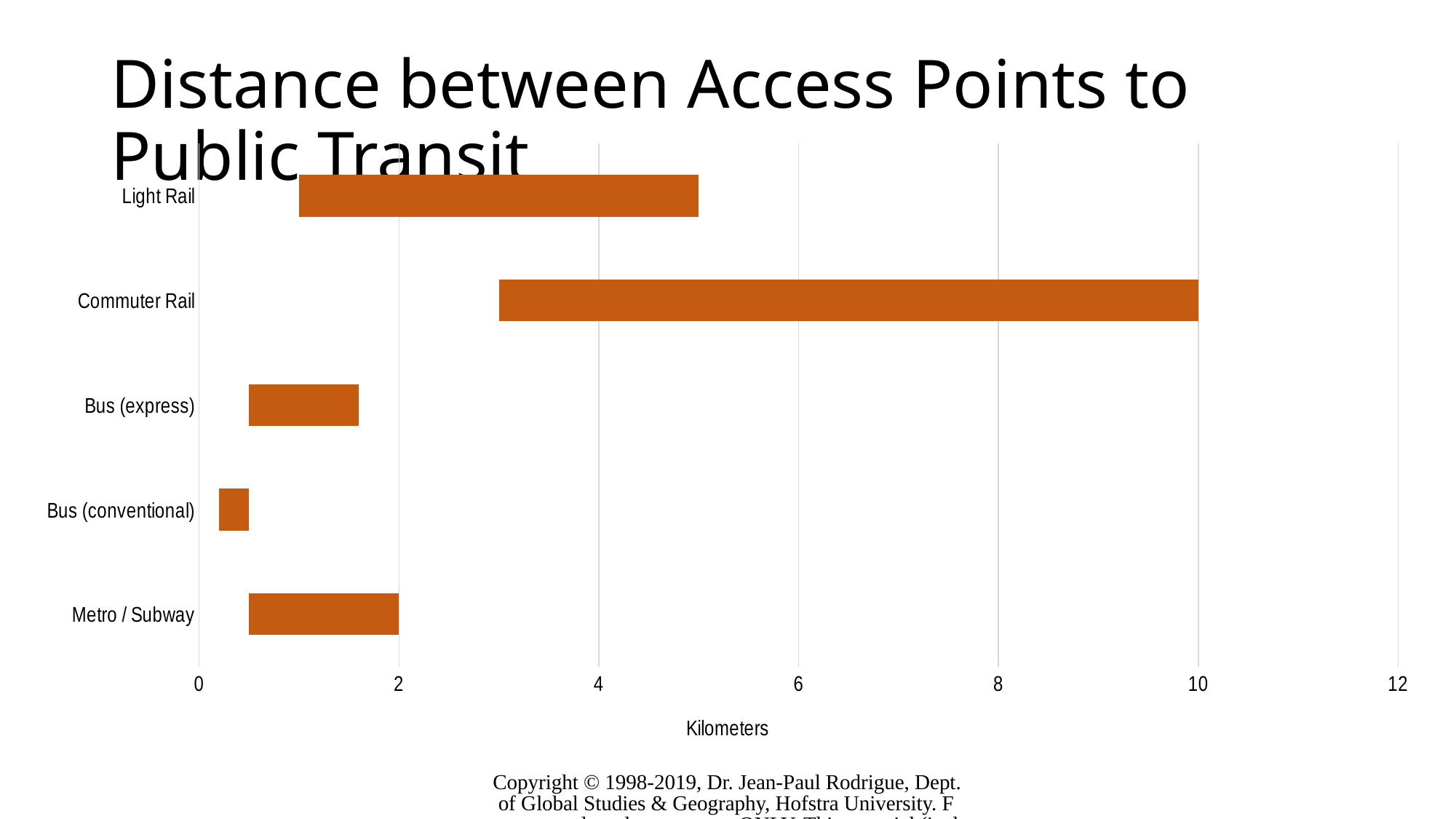
Is the upper end of the Bus (express) bar greater or less than 2? less Which category has the shortest bar (the smallest distance range)? Bus (conventional) What is the title of the chart? Distance between Access Points to Public Transit How many transit categories are plotted on the chart? 5 Which category has the bar extending furthest to the right (the greatest distance)? Commuter Rail At what value on the axis does the Commuter Rail bar end? 10 Is the upper end of the Bus (conventional) bar greater or less than 2? less At what value on the axis does the Metro / Subway bar end? 2 Is the upper end of the Light Rail bar greater or less than 4? greater What is the label on the horizontal axis? Kilometers What kind of chart is shown on the slide? bar chart Which bar extends further to the right, Light Rail or Metro / Subway? Light Rail